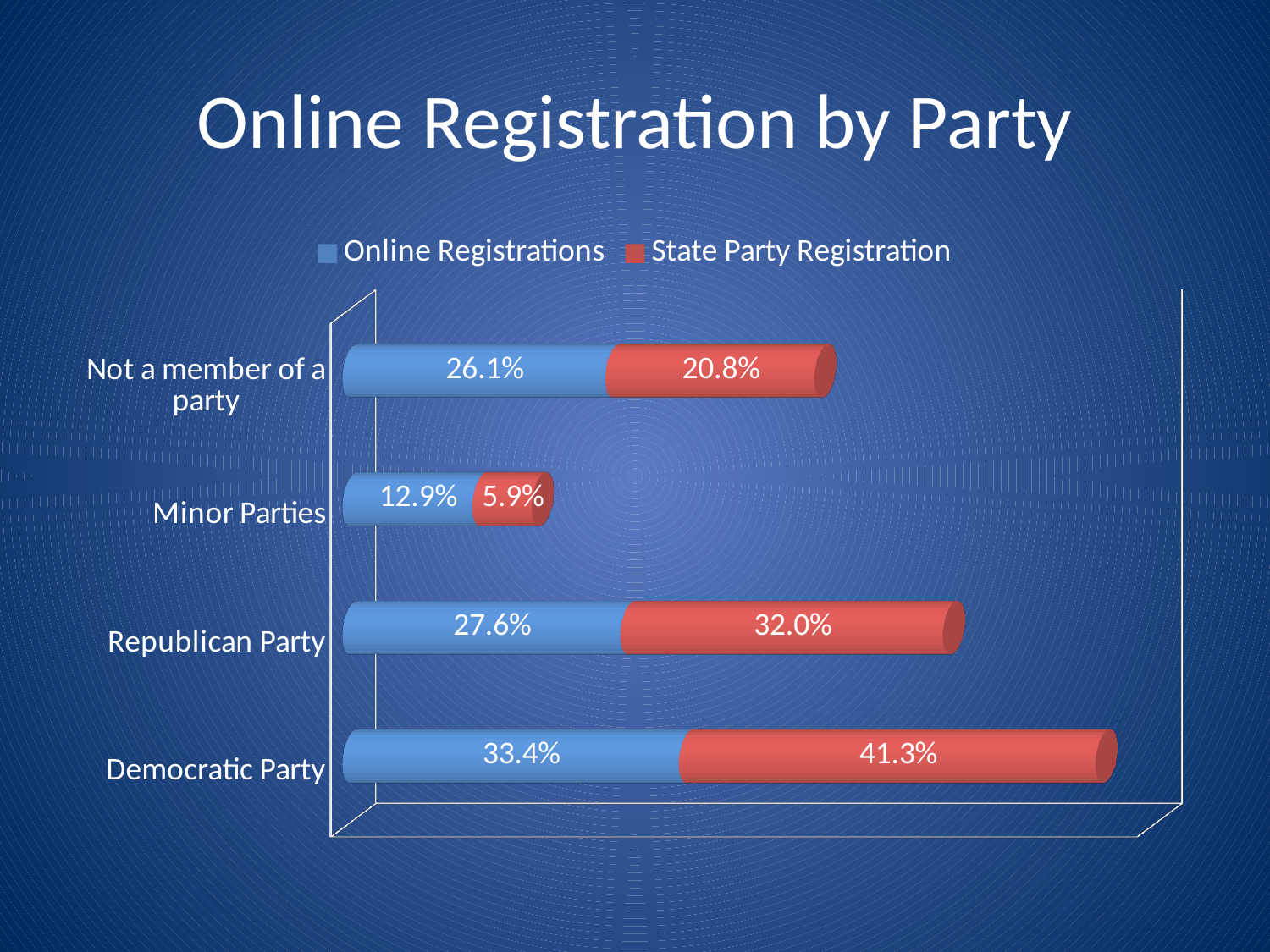
How many categories are shown on the chart? 4 What is the State Party Registration value for the Republican Party? 32.0% Which category has the highest State Party Registration value? Democratic Party What kind of chart is shown on the slide? Stacked bar chart What is the Online Registrations value for 'Not a member of a party'? 26.1% What is the difference between the State Party Registration and Online Registrations values for the Democratic Party? 7.9% What is the State Party Registration value for Minor Parties? 5.9% Which category has the lowest Online Registrations value? Minor Parties How many series does the legend list? 2 For 'Not a member of a party', which is larger: Online Registrations or State Party Registration? Online Registrations What is the title of the chart? Online Registration by Party What is the Online Registrations value for the Democratic Party? 33.4%